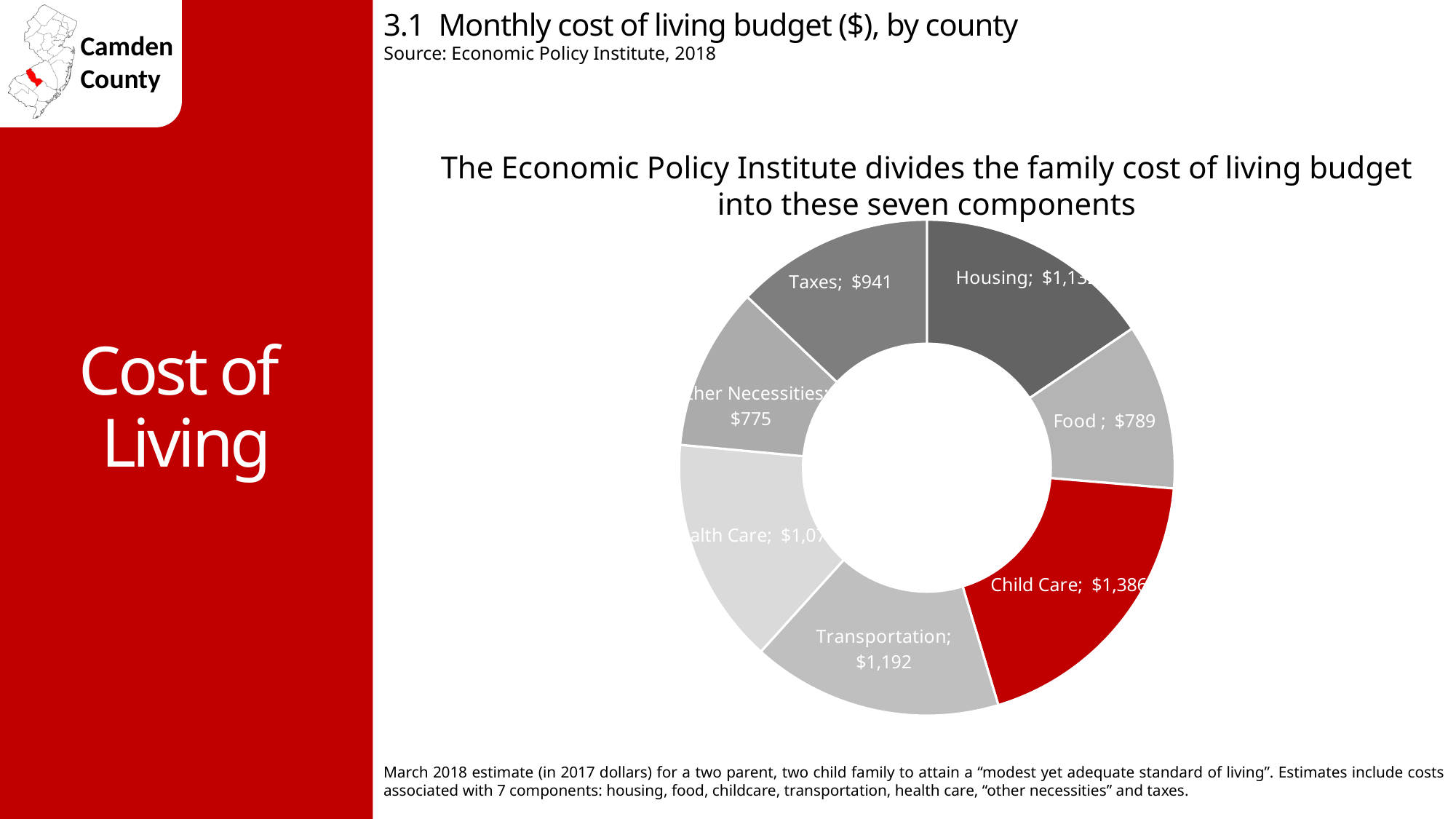
How many components are shown in the chart? 7 What type of chart is used on this slide? Doughnut (pie) chart Which is larger, the cost for Taxes or the cost for Food? Taxes What is the monthly cost for Taxes shown on the chart? $941 What is the monthly cost for Child Care shown on the chart? $1,386 What is the difference between the Taxes cost and the Food cost? $152 What is the monthly cost for Transportation shown on the chart? $1,192 Which component has the largest monthly cost in the chart? Child Care What is the monthly cost for Food shown on the chart? $789 How much larger is the Child Care cost than the Transportation cost? $194 Which component's slice is coloured red in the chart? Child Care What is the monthly cost for Other Necessities shown on the chart? $775